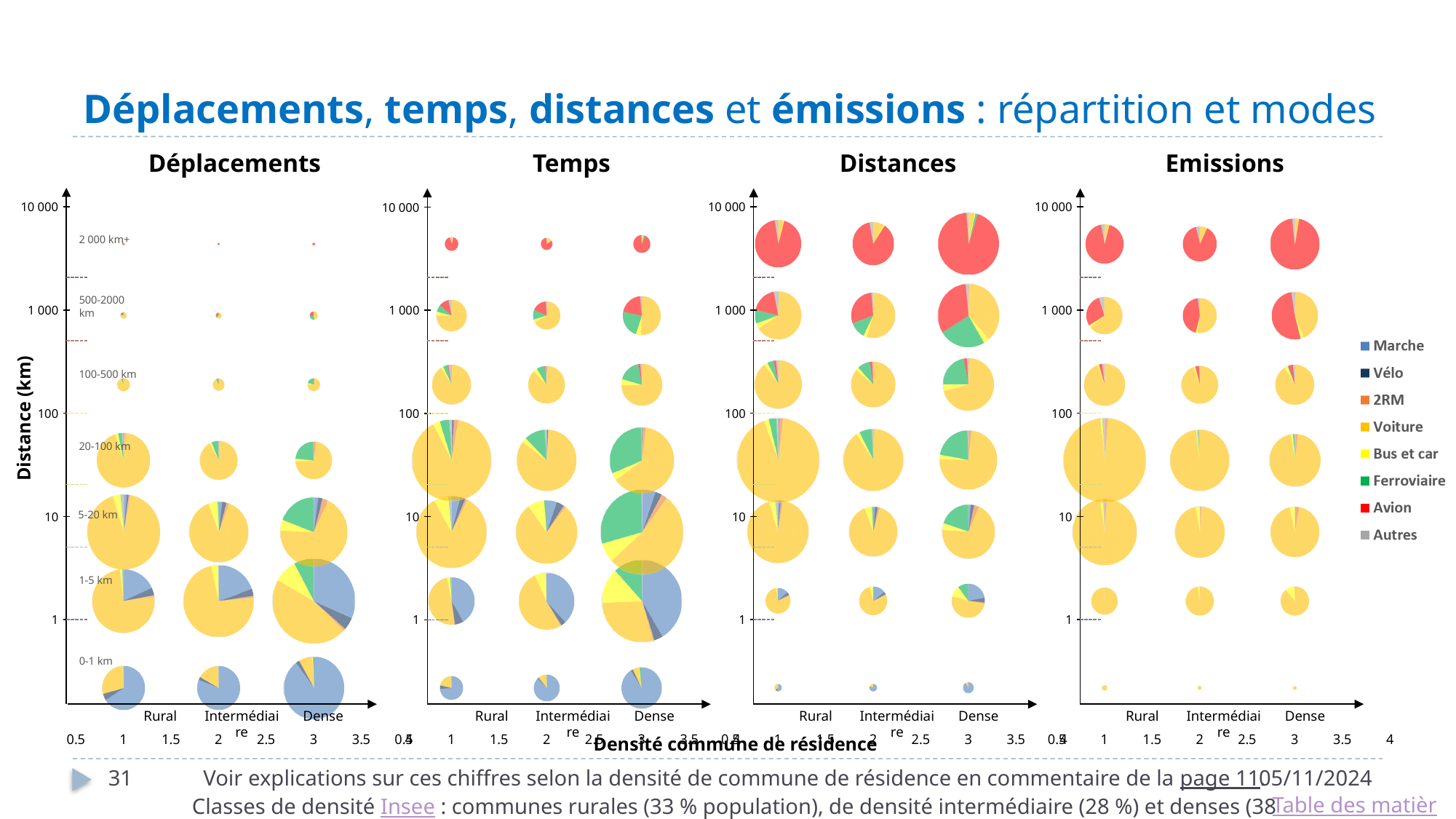
What kind of chart is the Déplacements chart? bubble chart What is the title of the leftmost chart? Déplacements Which mode in the legend is shown in red? Avion How many charts are shown on the slide? 4 In the Temps chart, how many density categories are shown on the x axis? 3 What is the highest tick value shown on the y axis of the Emissions chart? 10 000 In the Déplacements chart, how many distance bands are labelled along the y axis? 7 How many series (modes) does the legend list? 8